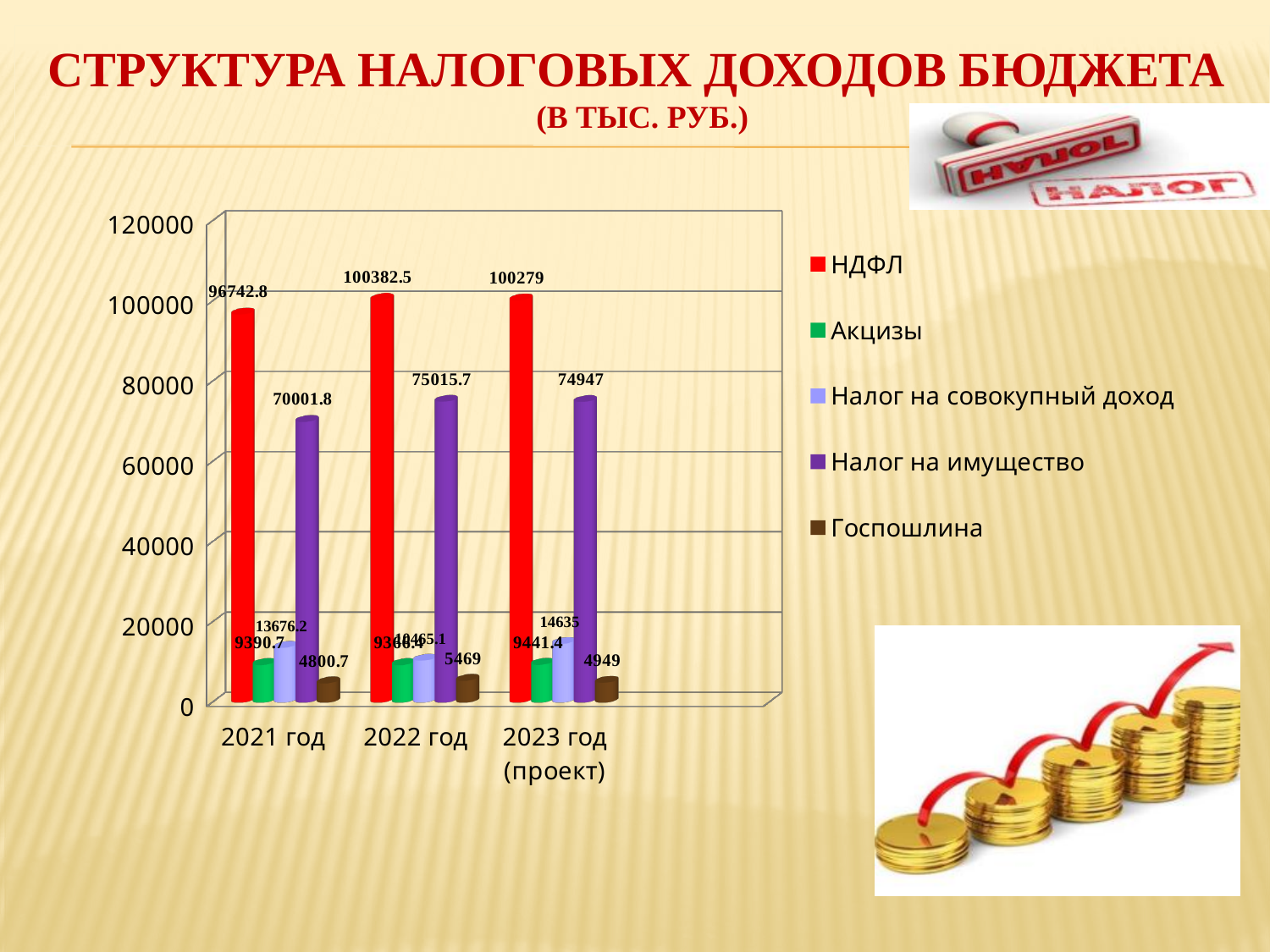
Which year has the highest value for НДФЛ? 2022 год Which series has the lowest value in 2021 год? Госпошлина What is the value of НДФЛ for 2021 год? 96742.8 What is the value of Налог на совокупный доход for 2023 год (проект)? 14635 Is the value of НДФЛ for 2023 год (проект) greater or less than 100000? greater What is the value of Госпошлина for 2023 год (проект)? 4949 What kind of chart is shown on the slide? Bar chart How many series does the legend list? 5 Which colour represents Налог на имущество in the legend? Purple What is the value of Налог на имущество for 2022 год? 75015.7 Which is larger: Госпошлина in 2022 год or Госпошлина in 2023 год (проект)? 2022 год What is the difference between Налог на имущество in 2022 год and in 2021 год? 5013.9